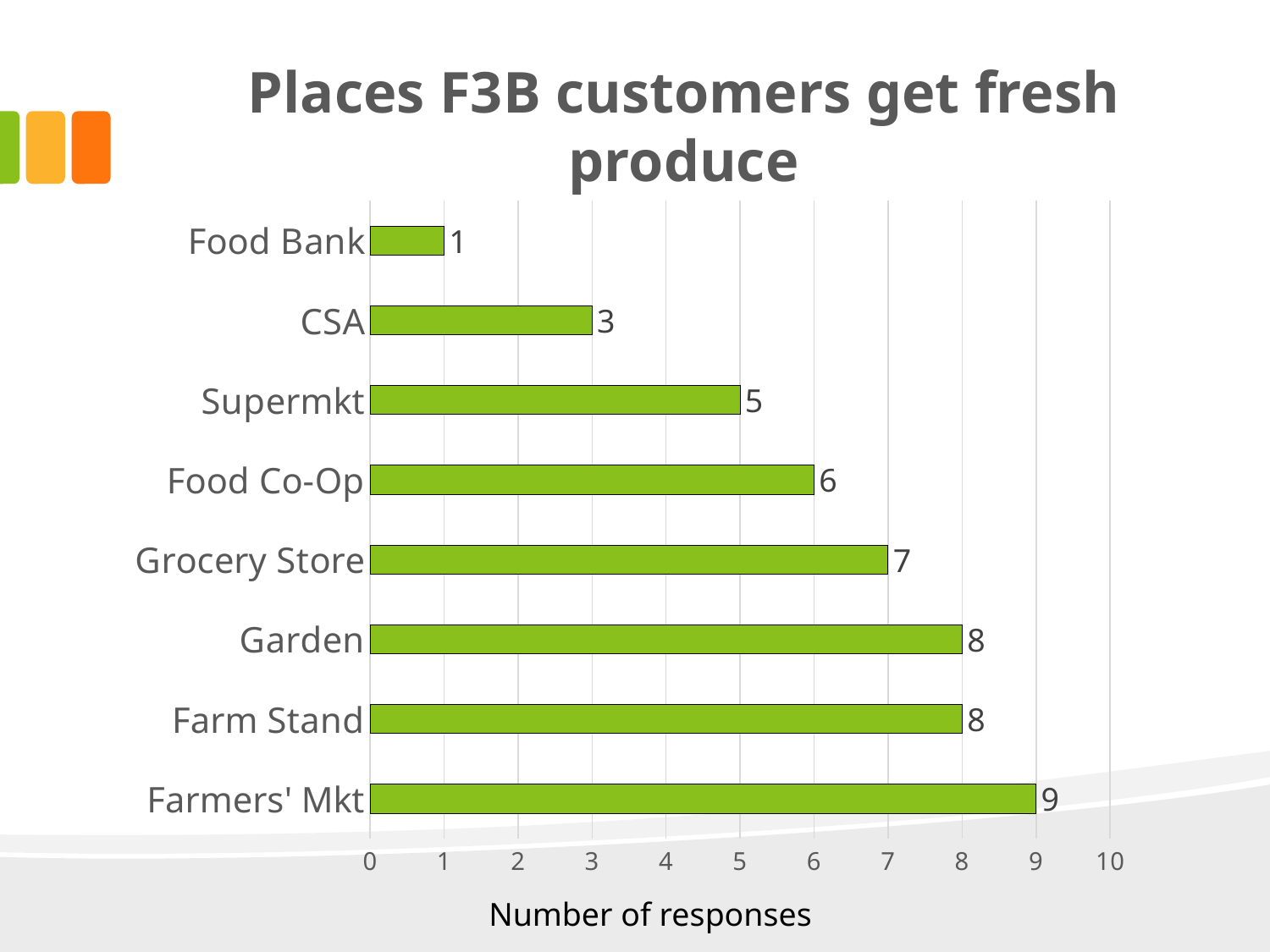
How many responses does Farmers' Mkt have? 9 What is the number of responses for Food Co-Op? 6 What is the value shown for CSA? 3 Which place has the lowest number of responses? Food Bank What is the label of the horizontal axis? Number of responses What is the difference in responses between Grocery Store and Supermkt? 2 Is the value for Grocery Store greater or less than 5? greater What is the difference in responses between Farmers' Mkt and Food Bank? 8 How many places are listed on the chart? 8 What kind of chart is shown on the slide? Bar chart Which place has the highest number of responses? Farmers' Mkt Which has more responses, Food Co-Op or CSA? Food Co-Op